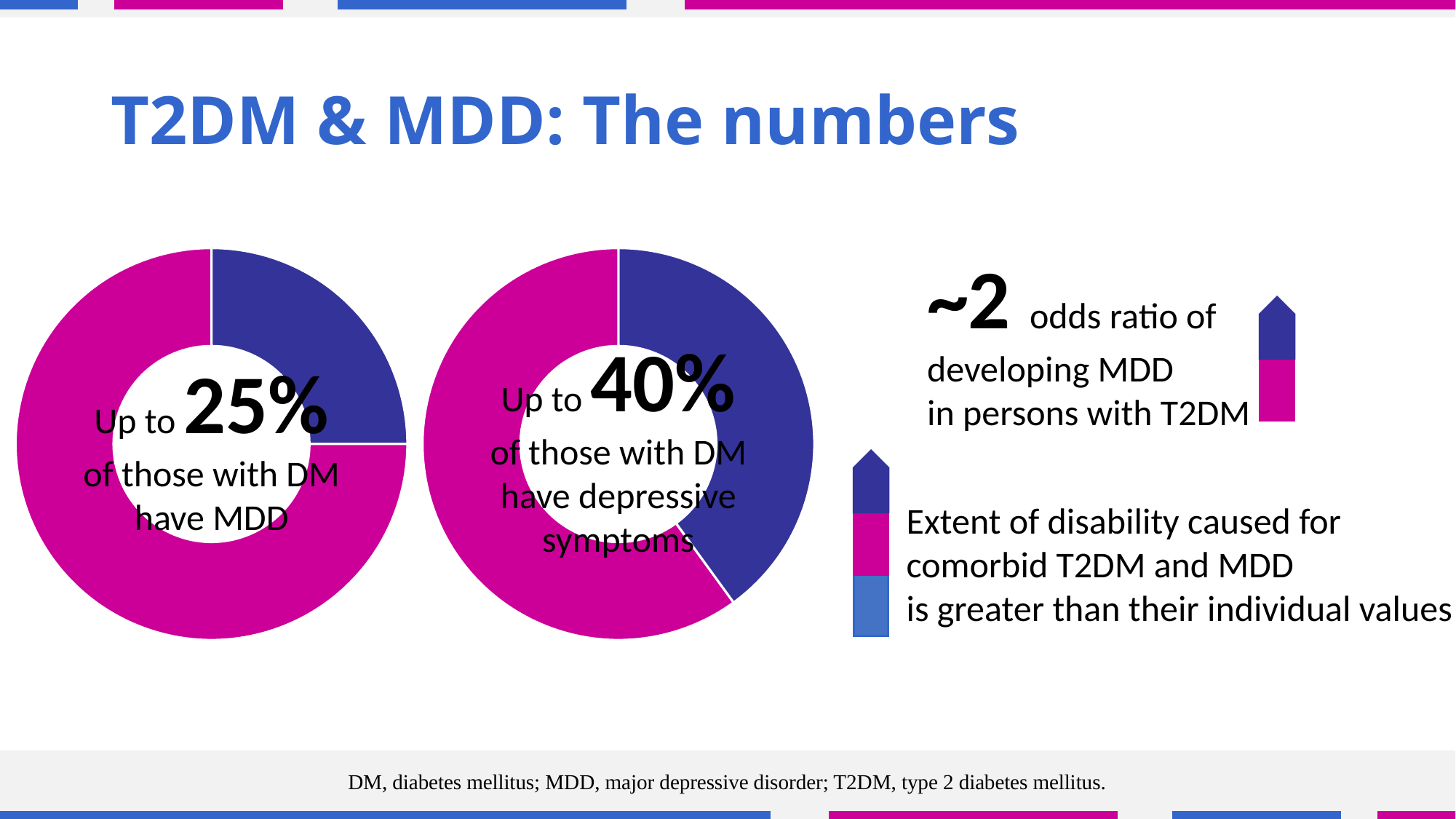
How many slices does each donut chart on the slide have? 2 How many donut charts are shown on the slide? 2 In the right donut chart, up to what percentage of those with DM have depressive symptoms? 40% In the right donut chart, which colour slice is larger, the magenta or the blue? Magenta In the right donut chart, what share of the ring does the blue slice represent? 40% What colour is the slice that represents the highlighted percentage in both donut charts? Blue In the left donut chart, what share of the ring does the blue slice represent? 25% Which is larger: the percentage of those with DM who have MDD (left chart) or the percentage with depressive symptoms (right chart)? Depressive symptoms (40%) In the left donut chart, is the blue slice greater or less than 50% of the ring? less In the left donut chart, up to what percentage of those with DM have MDD? 25% What is the difference in percentage points between the value in the right donut chart (40%) and the value in the left donut chart (25%)? 15 percentage points What kind of chart is used on the left side of the slide to show the share of those with DM who have MDD? Donut (pie) chart